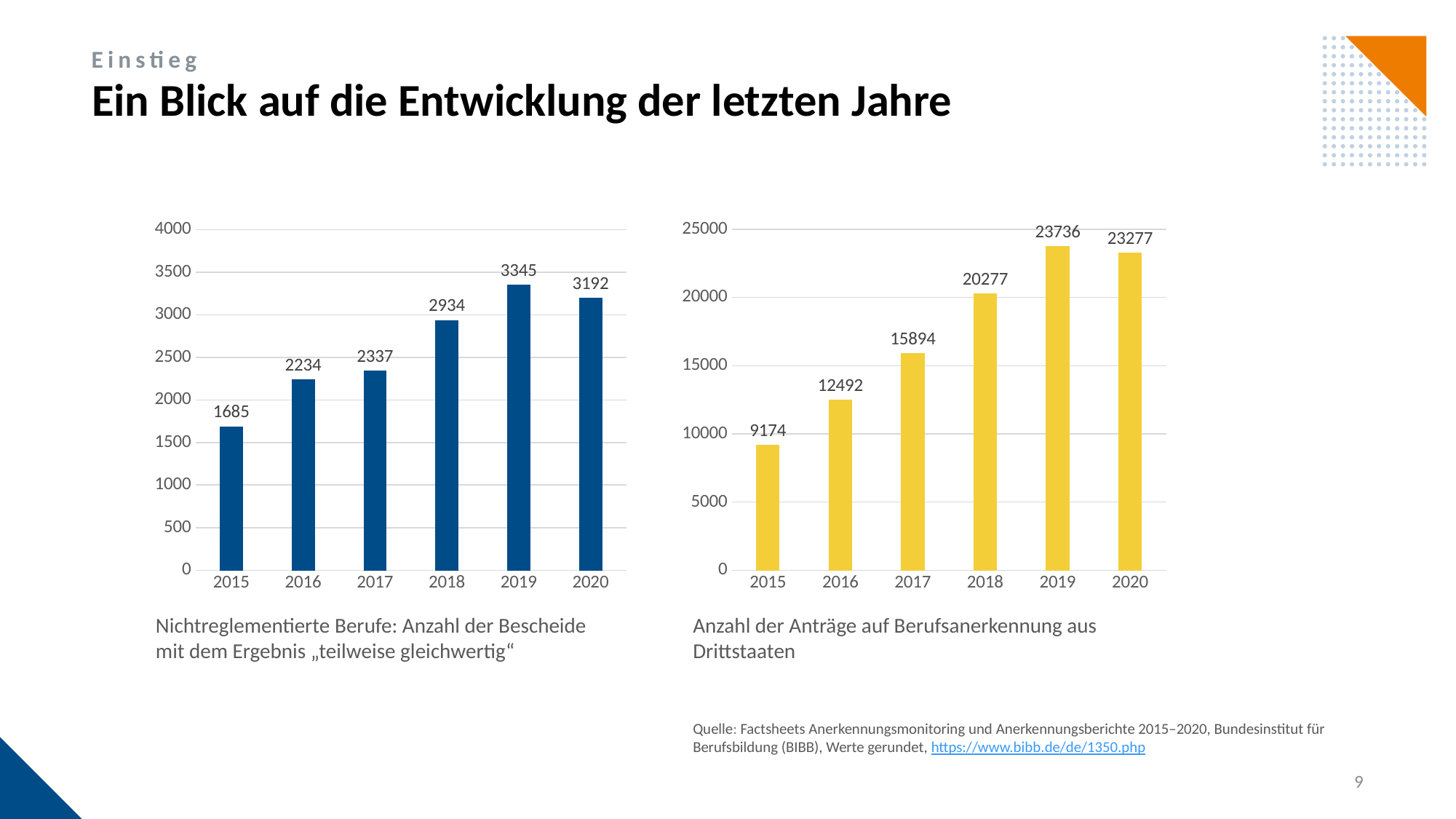
In the right chart (Anzahl der Anträge aus Drittstaaten), do the values rise or fall from 2015 to 2019? Rise What kind of chart is the right chart (Anzahl der Anträge aus Drittstaaten)? Bar chart In the right chart (Anzahl der Anträge aus Drittstaaten), what is the difference between the values for 2016 and 2015? 3318 What colour are the bars in the left chart (Nichtreglementierte Berufe)? Dark blue How many years are shown on the x axis of the left chart (Nichtreglementierte Berufe)? 6 In the right chart (Anzahl der Anträge aus Drittstaaten), which year has the lowest value? 2015 In the right chart (Anzahl der Anträge auf Berufsanerkennung aus Drittstaaten), what is the value for 2017? 15894 In the left chart (Nichtreglementierte Berufe), what is the value for 2018? 2934 In the left chart (Nichtreglementierte Berufe), which is larger, the value for 2016 or the value for 2017? 2017 In the left chart (Nichtreglementierte Berufe), what is the difference between the values for 2019 and 2020? 153 In the left chart (Nichtreglementierte Berufe), which year has the highest value? 2019 In the right chart (Anzahl der Anträge aus Drittstaaten), is the value for 2018 greater or less than 20000? greater